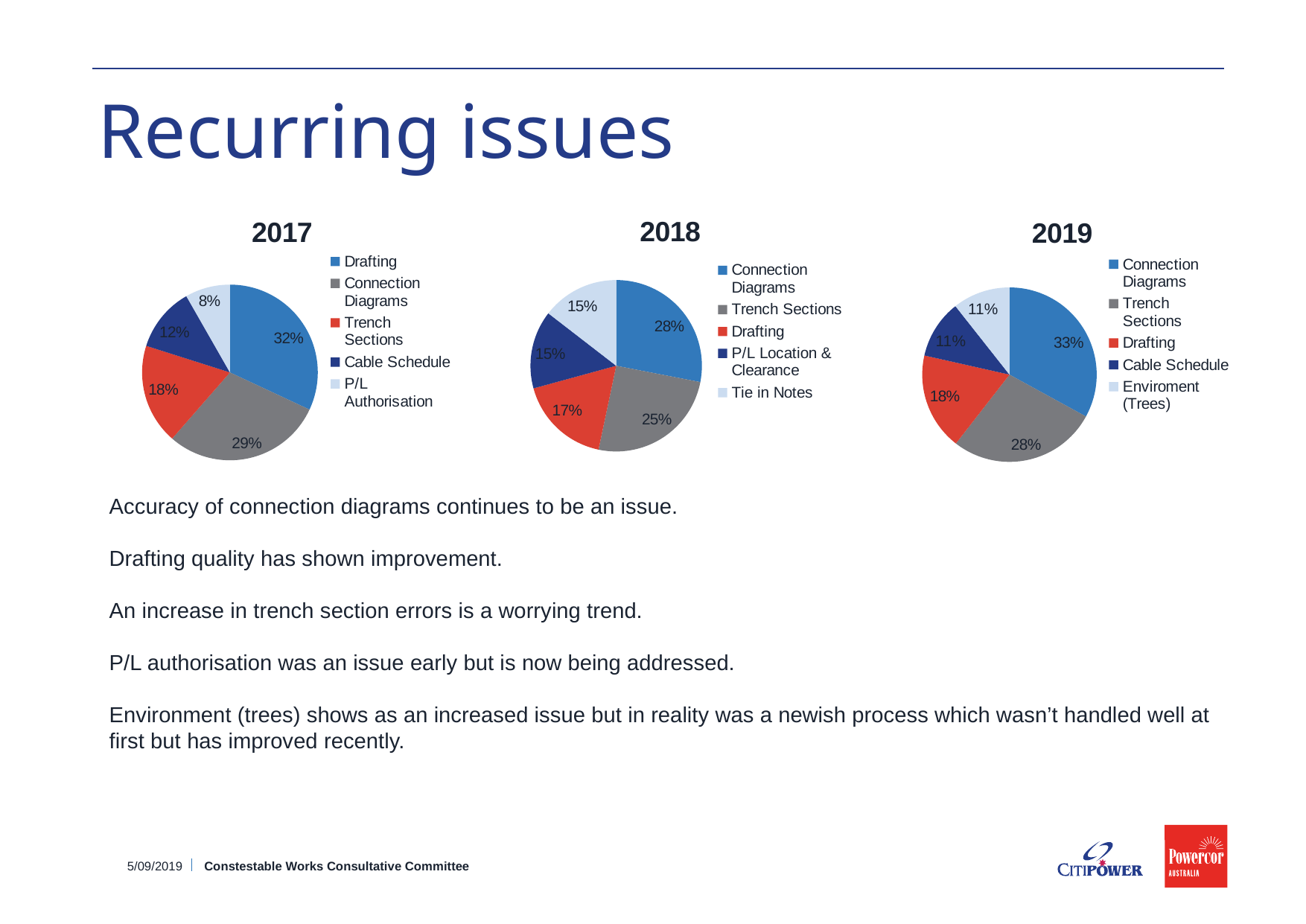
What kind of chart is the 2019 chart? Pie chart In the 2017 chart, what share does Drafting have? 32% In the 2019 chart, what share does Connection Diagrams have? 33% In the 2018 chart, what share do Trench Sections have? 25% In the 2018 chart, what share does Drafting have? 17% In the 2017 chart, what is the difference between the Drafting and Trench Sections shares? 14% In the 2018 chart, how many categories does the legend list? 5 In the 2019 chart, what is the difference between the Connection Diagrams and Cable Schedule shares? 22% In the 2018 chart, which category has the largest share? Connection Diagrams In the 2017 chart, which category has the smallest share? P/L Authorisation In the 2019 chart, which is larger, Trench Sections or Drafting? Trench Sections How many pie charts are shown on the slide? 3